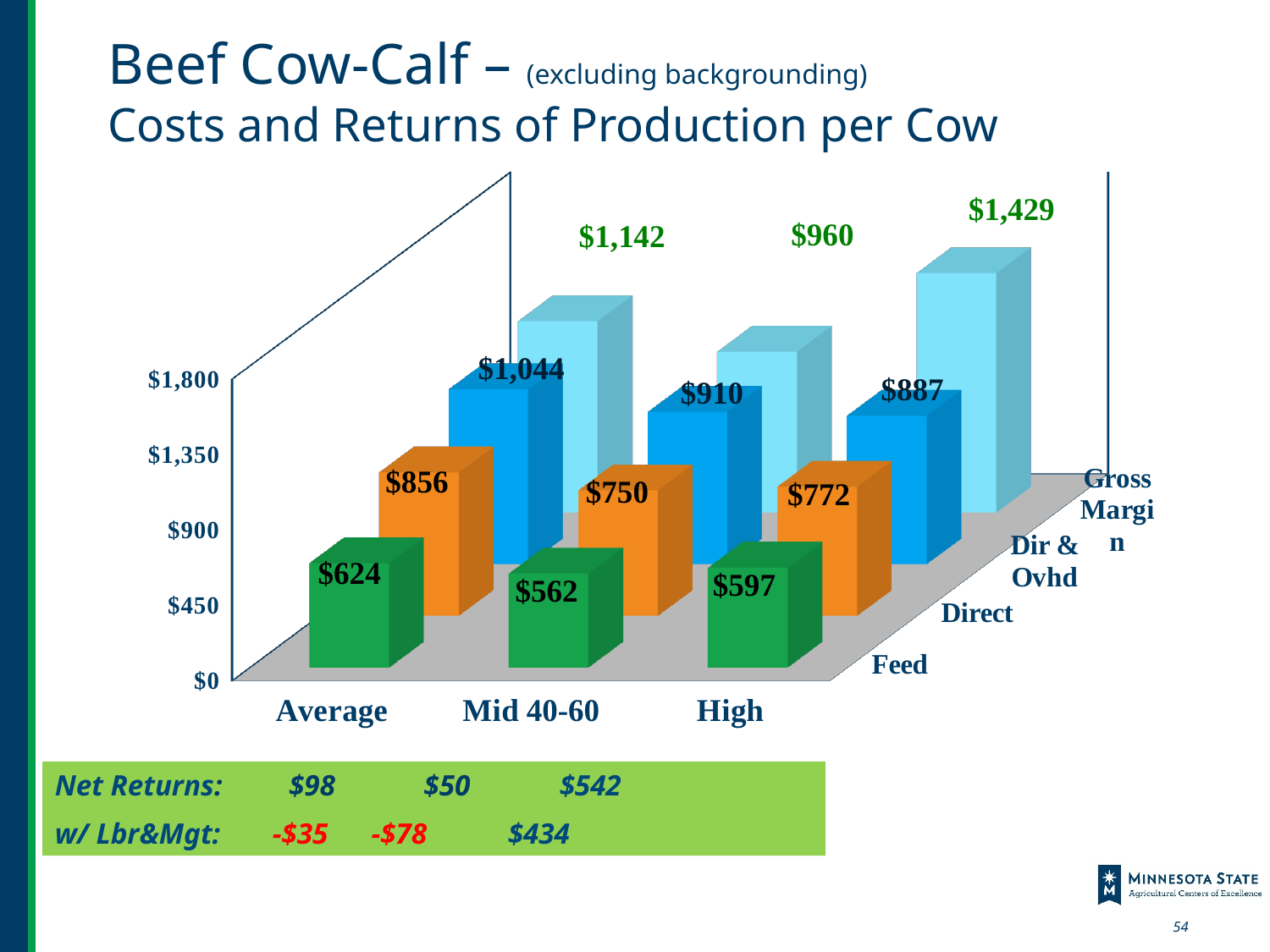
What is the Direct value for the Mid 40-60 group? $750 Which is larger, the Direct value for Average or the Direct value for High? Direct value for Average What is the difference between the Gross Margin for High and the Gross Margin for Mid 40-60? $469 How many groups are shown on the x axis of the chart? 3 What is the Dir & Ovhd value for the High group? $887 What is the Gross Margin value for the High group? $1,429 What is the difference between the Dir & Ovhd value for Average and the Dir & Ovhd value for Mid 40-60? $134 Which group has the highest Gross Margin? High Which group has the lowest Feed value? Mid 40-60 What kind of chart is shown on the slide? Bar chart What is the Feed value for the Average group? $624 How many series are plotted in the chart? 4